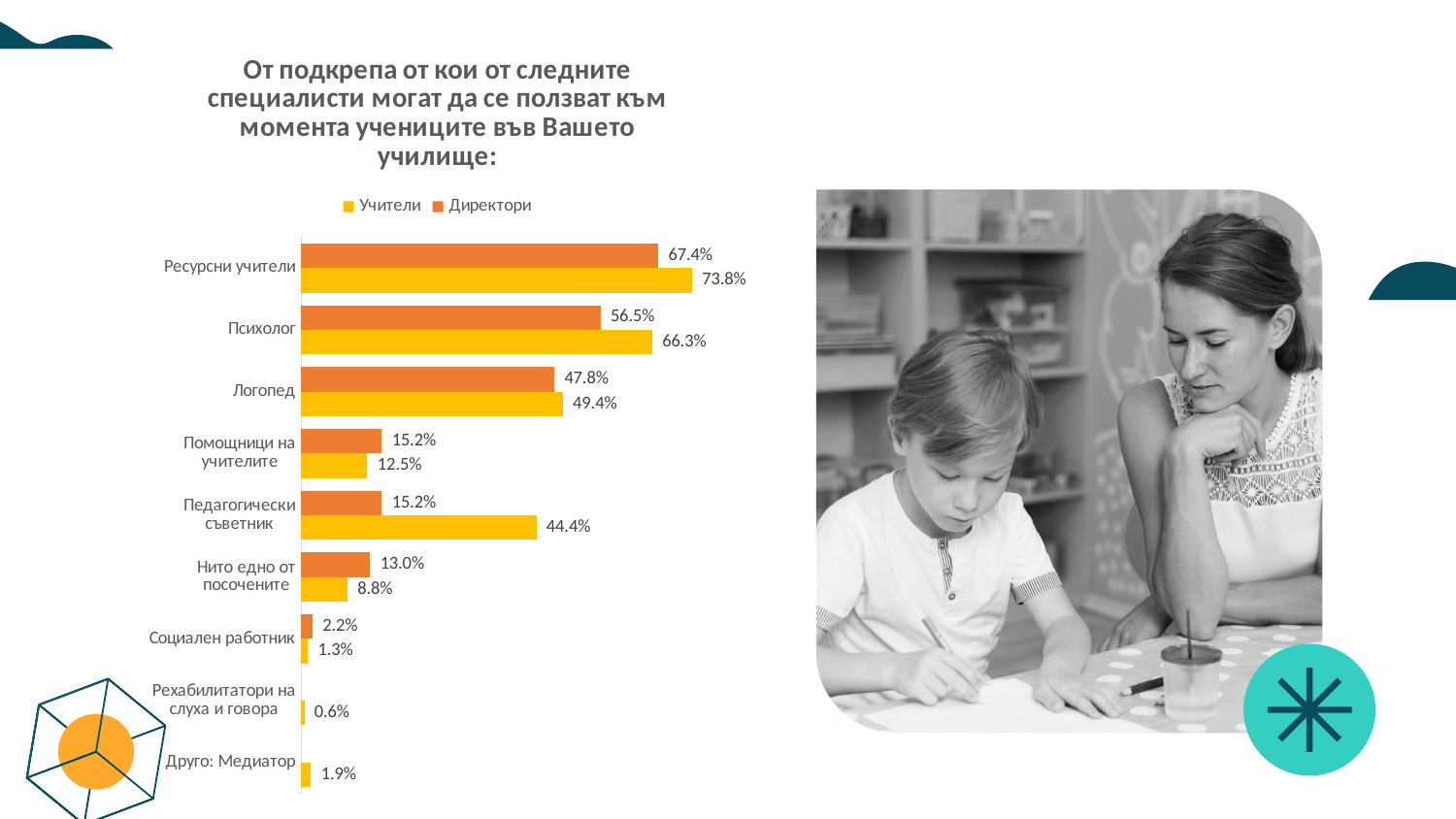
What is the difference between the Учители and Директори values for Педагогически съветник? 29.2% What kind of chart is shown on the slide? Bar chart How many series does the legend list? 2 For Помощници на учителите, which is larger: the value for Учители or for Директори? Директори Which category has the highest value for Директори? Ресурсни учители Which category has the lowest value for Учители? Рехабилитатори на слуха и говора Which colour represents the Директори series in the chart? Orange What is the value for Директори for Психолог? 56.5% What is the value for Учители for Педагогически съветник? 44.4% What is the value for Учители for Ресурсни учители? 73.8% How many categories are shown on the chart? 9 What is the value for Директори for Нито едно от посочените? 13.0%